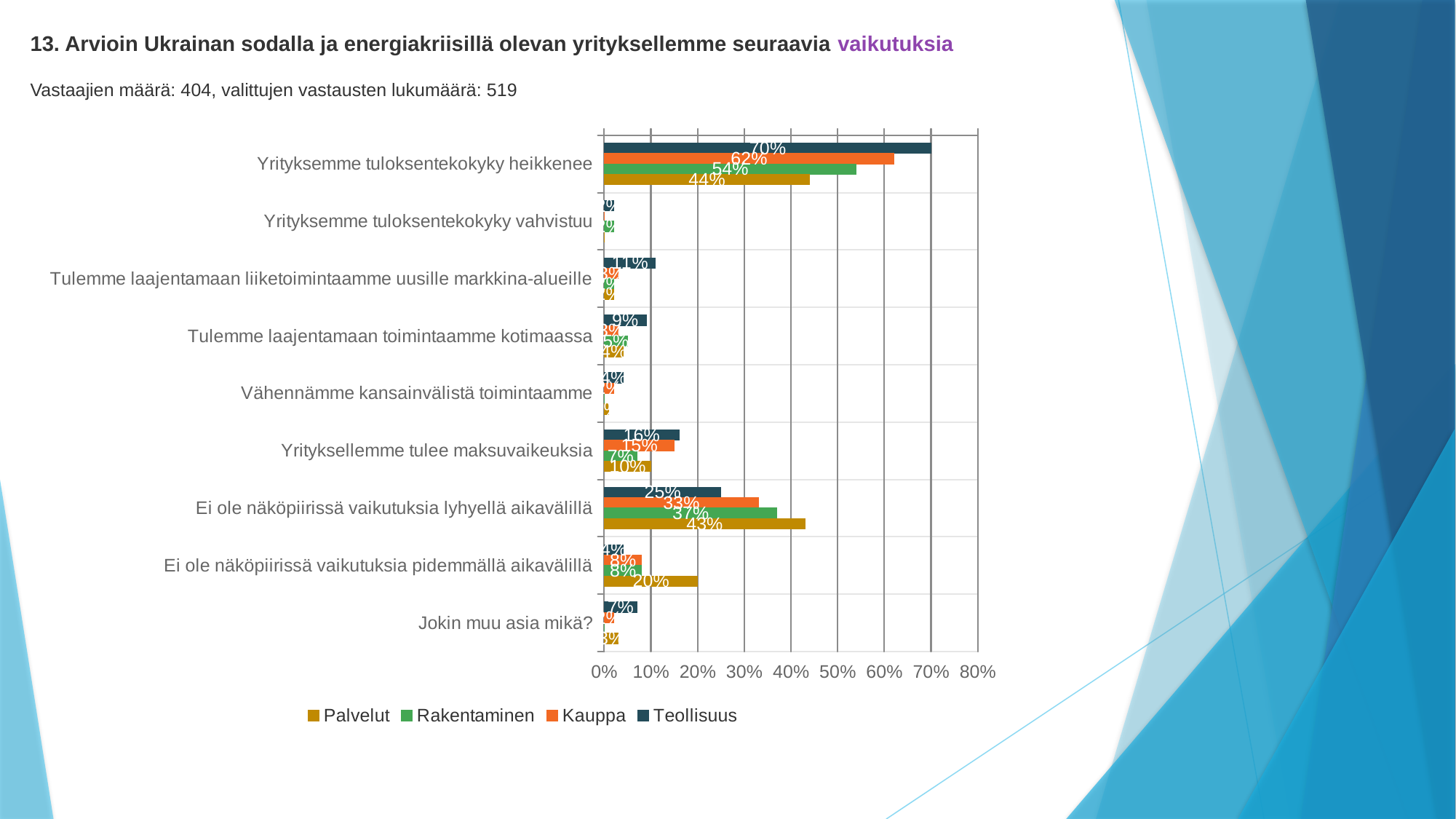
Which series has the lowest value for "Ei ole näköpiirissä vaikutuksia lyhyellä aikavälillä"? Teollisuus What is the Palvelut value for "Ei ole näköpiirissä vaikutuksia lyhyellä aikavälillä"? 43% How many categories are shown on the chart? 9 Is the Palvelut value for "Yrityksemme tuloksentekokyky heikkenee" greater or less than 40%? greater What is the Kauppa value for "Yrityksellemme tulee maksuvaikeuksia"? 15% Which series has the highest value for "Yrityksemme tuloksentekokyky heikkenee"? Teollisuus What is the difference between the Kauppa and Rakentaminen values for "Yrityksemme tuloksentekokyky heikkenee"? 8% For "Ei ole näköpiirissä vaikutuksia pidemmällä aikavälillä", which is larger: the Palvelut value or the Rakentaminen value? Palvelut How many series does the legend list? 4 Which series is shown in orange in the legend? Kauppa What is the Teollisuus value for "Yrityksemme tuloksentekokyky heikkenee"? 70% What kind of chart is shown on the slide? bar chart